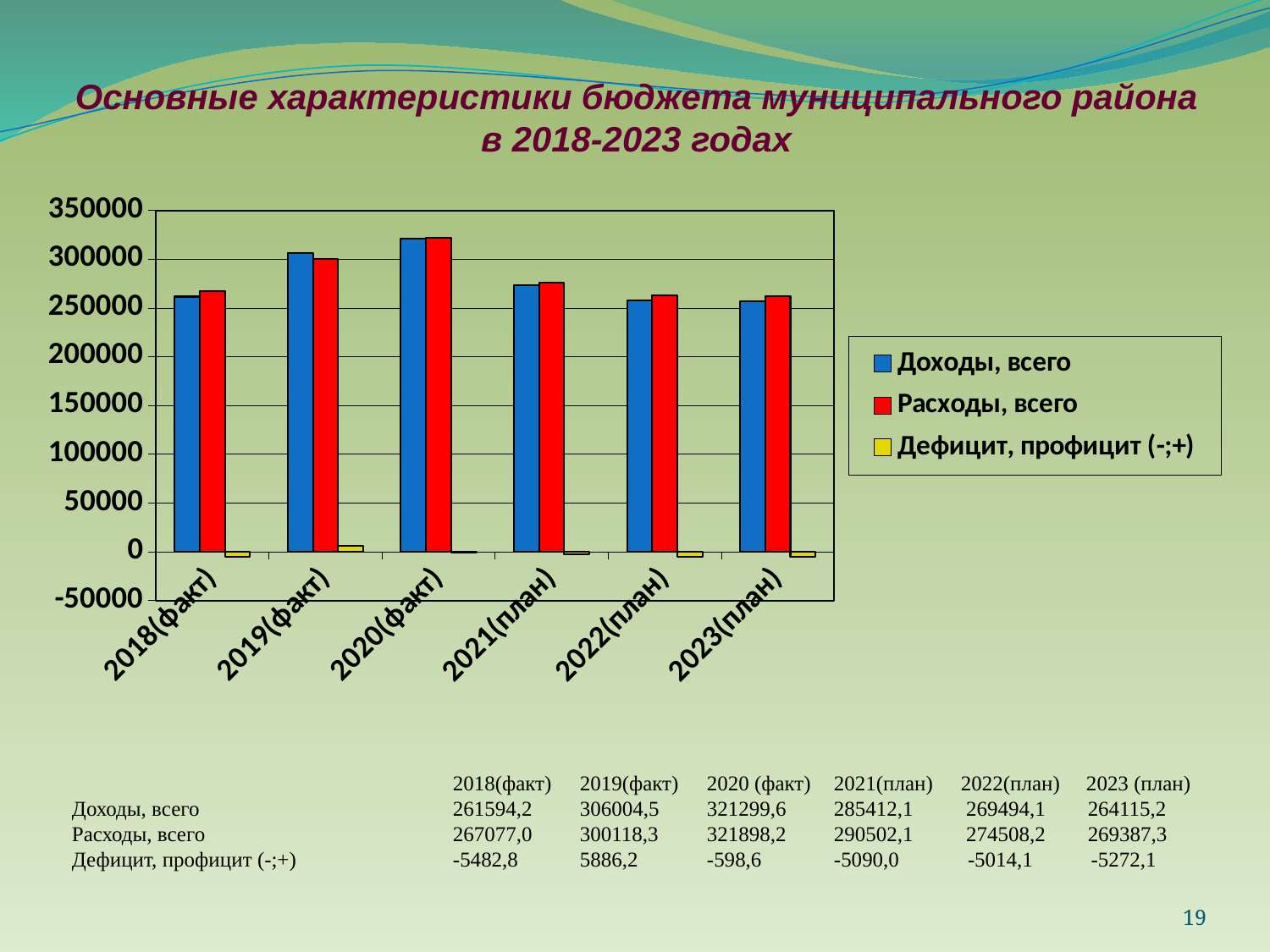
How many series does the chart legend list? 3 What is the value of Доходы, всего for 2020 (факт)? 321299,6 What is the value of Расходы, всего for 2018 (факт)? 267077,0 In which year is Дефицит, профицит (-;+) the highest? 2019 (факт) What is the difference between Расходы, всего and Доходы, всего for 2018 (факт)? 5482,8 What is the value of Дефицит, профицит (-;+) for 2019 (факт)? 5886,2 Is the value of Доходы, всего for 2022 (план) greater or less than 300000? less For 2019 (факт), which is larger: Доходы, всего or Расходы, всего? Доходы, всего In which year is Доходы, всего the highest? 2020 (факт) How many year categories are shown on the x axis of the chart? 6 What type of chart is shown on the slide? bar chart What colour are the bars for Расходы, всего in the chart? red